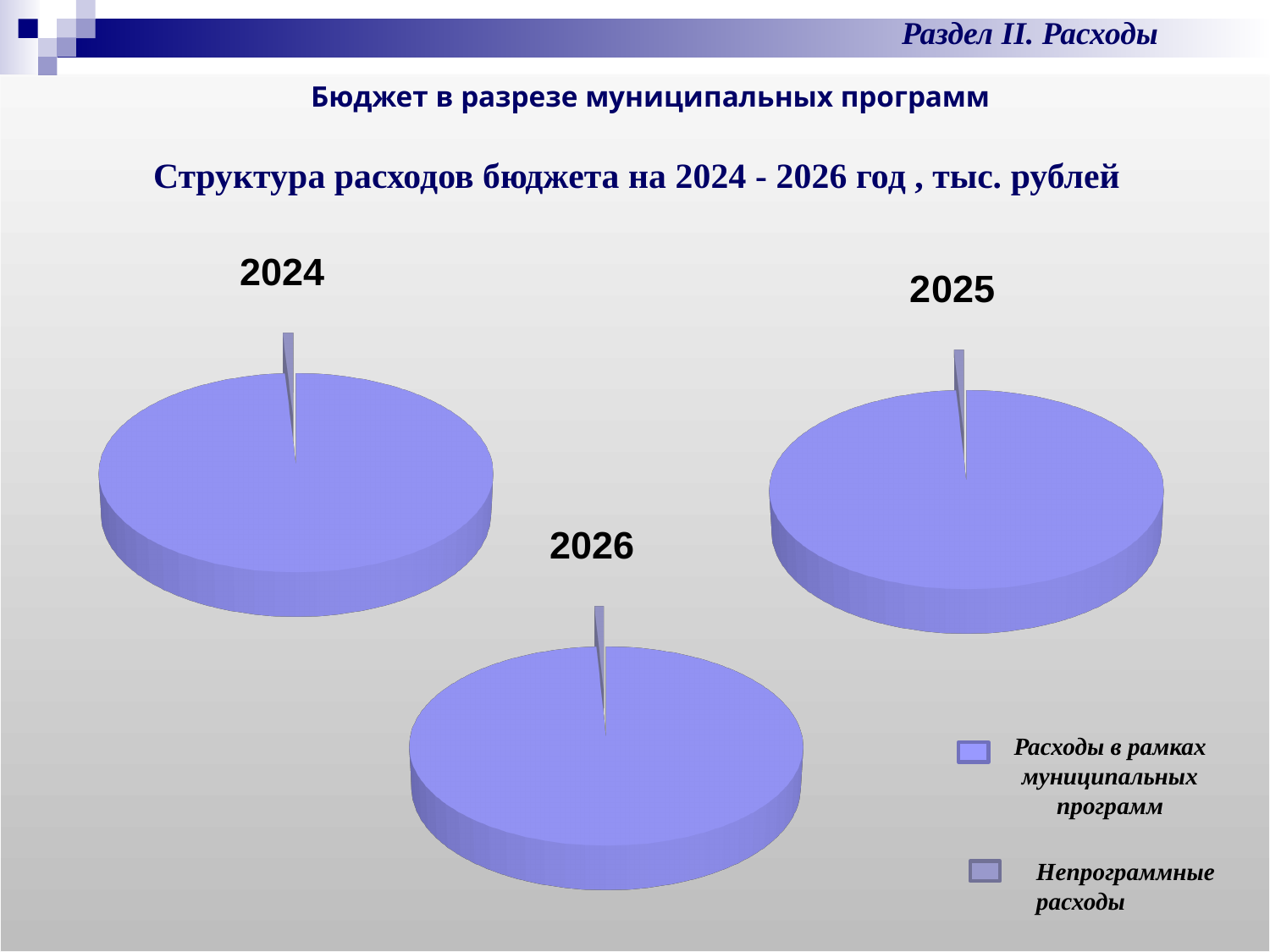
In the 2025 pie chart, which category has the smaller slice? Непрограммные расходы In the 2024 pie chart, which category has the larger slice: Расходы в рамках муниципальных программ or Непрограммные расходы? Расходы в рамках муниципальных программ What kind of chart is used for the 2024 data on this slide? Pie chart What is the title of the chart group on the slide? Структура расходов бюджета на 2024 - 2026 год , тыс. рублей How many categories does the legend list? 2 Which legend entry is shown with the darker colour? Непрограммные расходы In the 2026 pie chart, which category takes up the largest share? Расходы в рамках муниципальных программ Which years are covered by the pie charts on the slide? 2024, 2025, 2026 In the 2026 pie chart, which category has the smaller slice: Расходы в рамках муниципальных программ or Непрограммные расходы? Непрограммные расходы How many pie charts are shown on the slide? 3